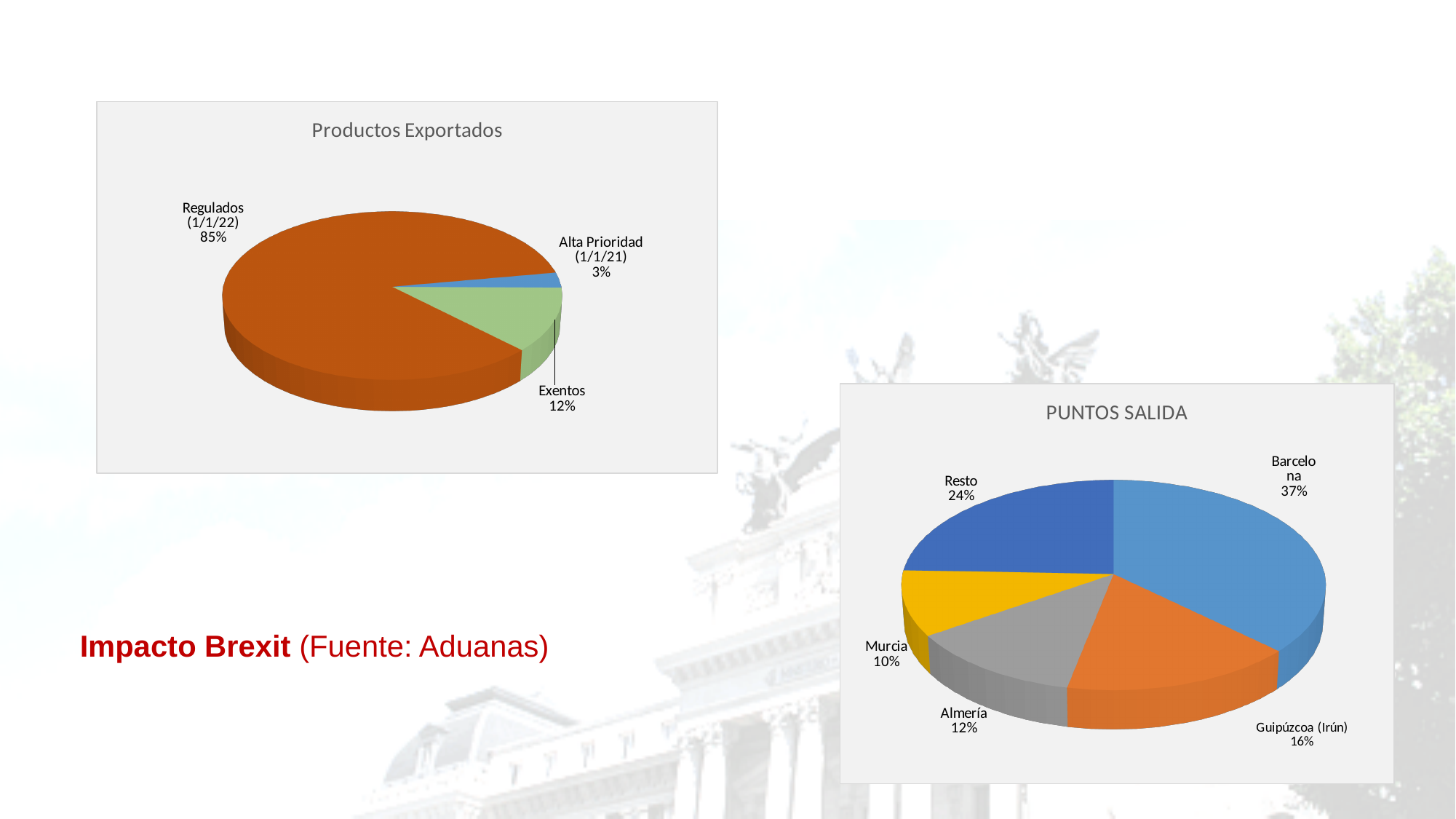
In the 'Productos Exportados' chart, what share does 'Exentos' have? 12% In the 'PUNTOS SALIDA' chart, what share does Guipúzcoa (Irún) have? 16% In the 'Productos Exportados' chart, which category has the smallest slice? Alta Prioridad (1/1/21) In the 'PUNTOS SALIDA' chart, which is larger, Guipúzcoa (Irún) or Murcia? Guipúzcoa (Irún) In the 'PUNTOS SALIDA' chart, which category has the largest slice? Barcelona What kind of chart is 'Productos Exportados'? Pie chart In the 'Productos Exportados' chart, what share does 'Regulados (1/1/22)' have? 85% In the 'PUNTOS SALIDA' chart, how many slices are there? 5 In the 'PUNTOS SALIDA' chart, what is the difference between the shares of Resto and Almería? 12% In the 'PUNTOS SALIDA' chart, which category has the smallest slice? Murcia In the 'Productos Exportados' chart, how many slices are there? 3